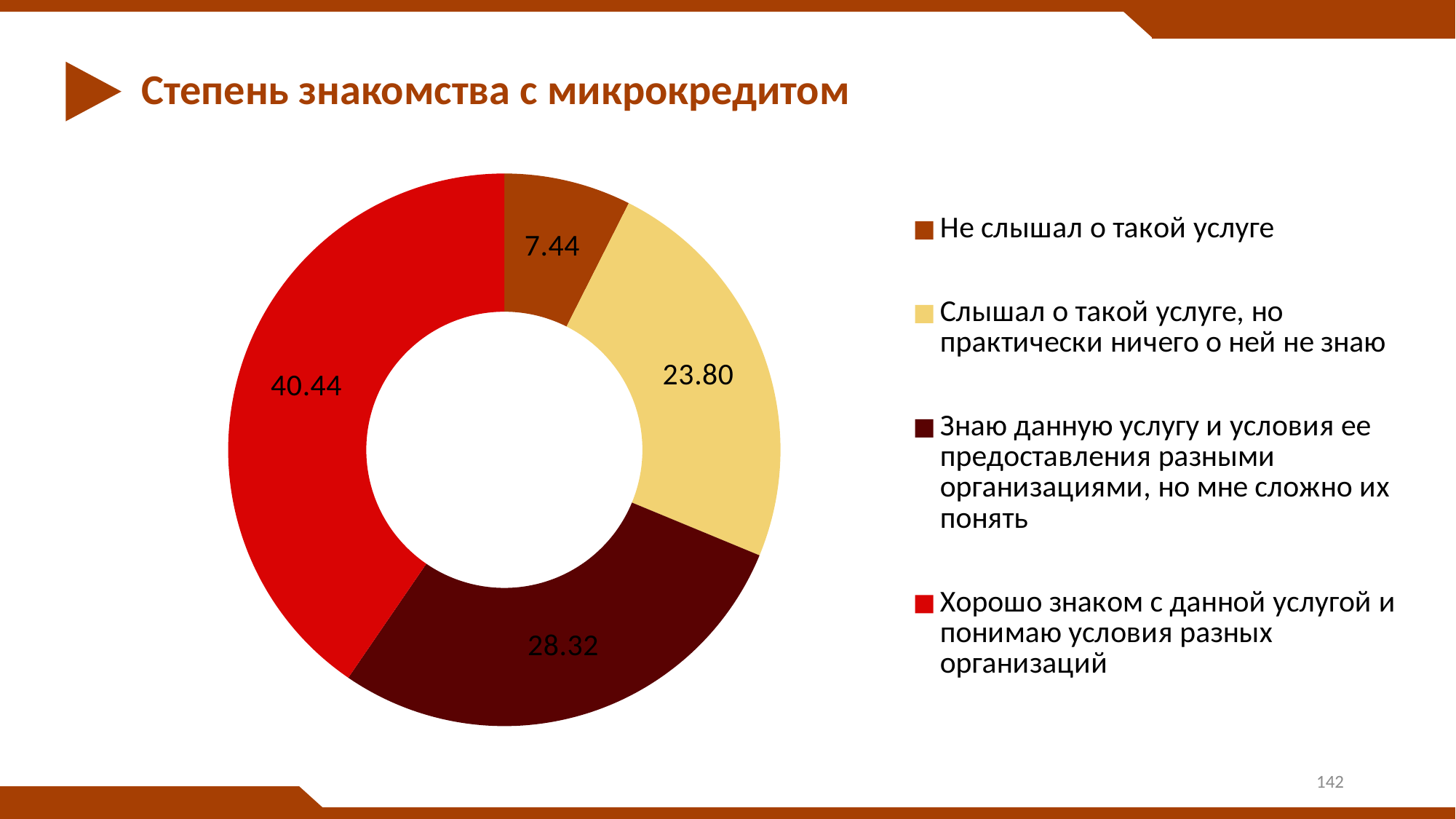
What is the difference between the values for "Хорошо знаком с данной услугой и понимаю условия разных организаций" and "Не слышал о такой услуге"? 33.00 What is the value for "Не слышал о такой услуге"? 7.44 Which category has the largest share of the chart? Хорошо знаком с данной услугой и понимаю условия разных организаций What is the value for "Знаю данную услугу и условия ее предоставления разными организациями, но мне сложно их понять"? 28.32 What is the value for "Слышал о такой услуге, но практически ничего о ней не знаю"? 23.80 What is the title of the slide? Степень знакомства с микрокредитом How many categories does the chart show? 4 What is the value for "Хорошо знаком с данной услугой и понимаю условия разных организаций"? 40.44 Which category has the smallest share of the chart? Не слышал о такой услуге Which is larger: the value for "Слышал о такой услуге, но практически ничего о ней не знаю" or the value for "Знаю данную услугу и условия ее предоставления разными организациями, но мне сложно их понять"? Знаю данную услугу и условия ее предоставления разными организациями, но мне сложно их понять What type of chart is shown on the slide? Doughnut (pie) chart What is the difference between the values for "Знаю данную услугу и условия ее предоставления разными организациями, но мне сложно их понять" and "Слышал о такой услуге, но практически ничего о ней не знаю"? 4.52